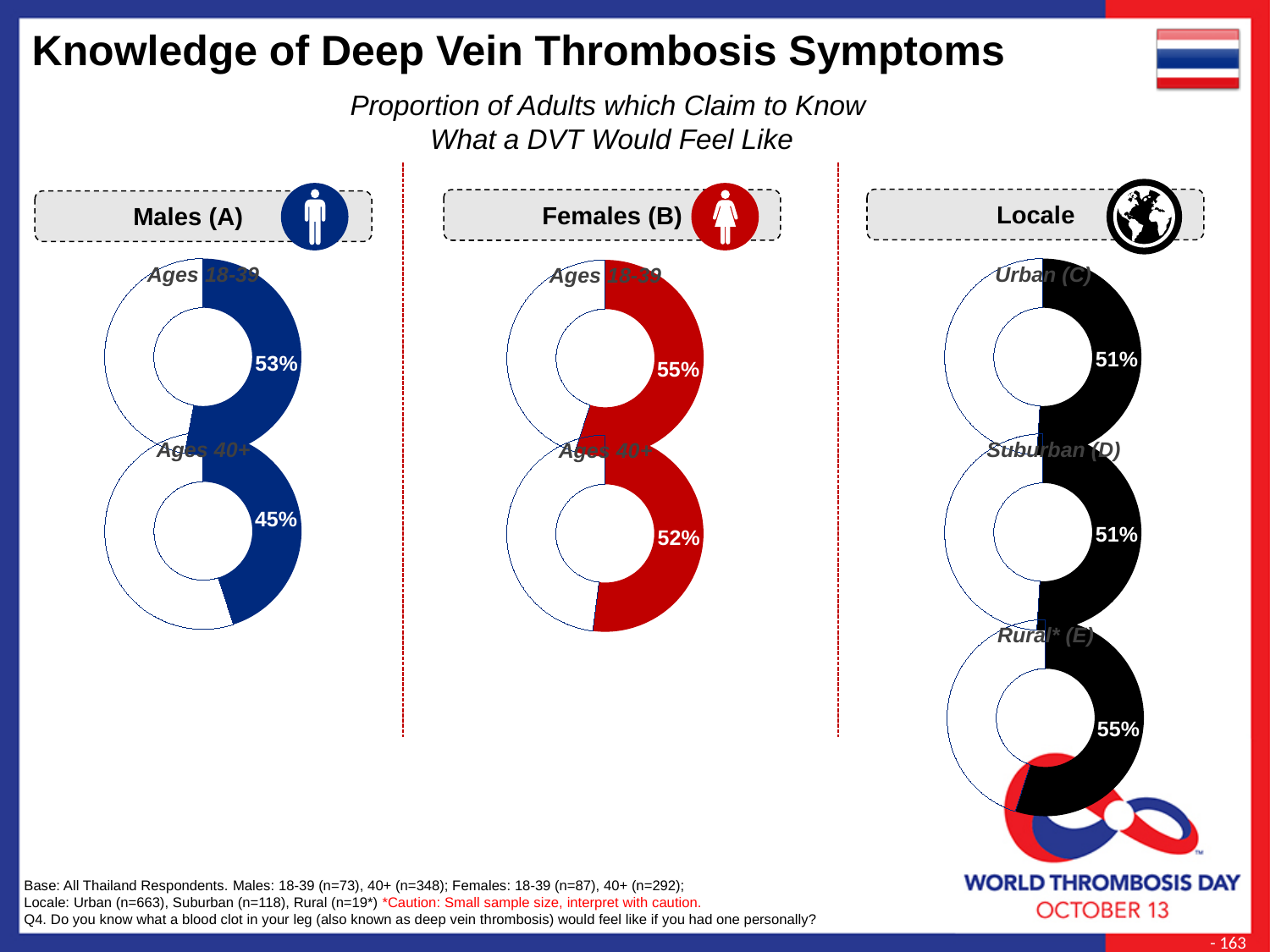
In the Females (B) section, what is the value shown for Ages 18-39? 55% In the Males (A) section, what is the value shown for Ages 40+? 45% How many donut charts are shown in the Locale section? 3 In the Locale section, what is the value shown for Urban (C)? 51% Across all seven donut charts on the slide, which group has the lowest value? Males Ages 40+ In the Locale section, what is the value shown for Rural* (E)? 55% In the Females (B) section, what is the difference between the Ages 18-39 value and the Ages 40+ value? 3% Which is larger: the Males Ages 18-39 value or the Females Ages 18-39 value? Females Ages 18-39 What type of chart is used to display the values on this slide? Donut (pie) chart In the Females (B) section, what is the value shown for Ages 40+? 52% In the Males (A) section, what is the difference between the Ages 18-39 value and the Ages 40+ value? 8% In the Males (A) section, what percentage of adults aged 18-39 claim to know what a DVT would feel like? 53%